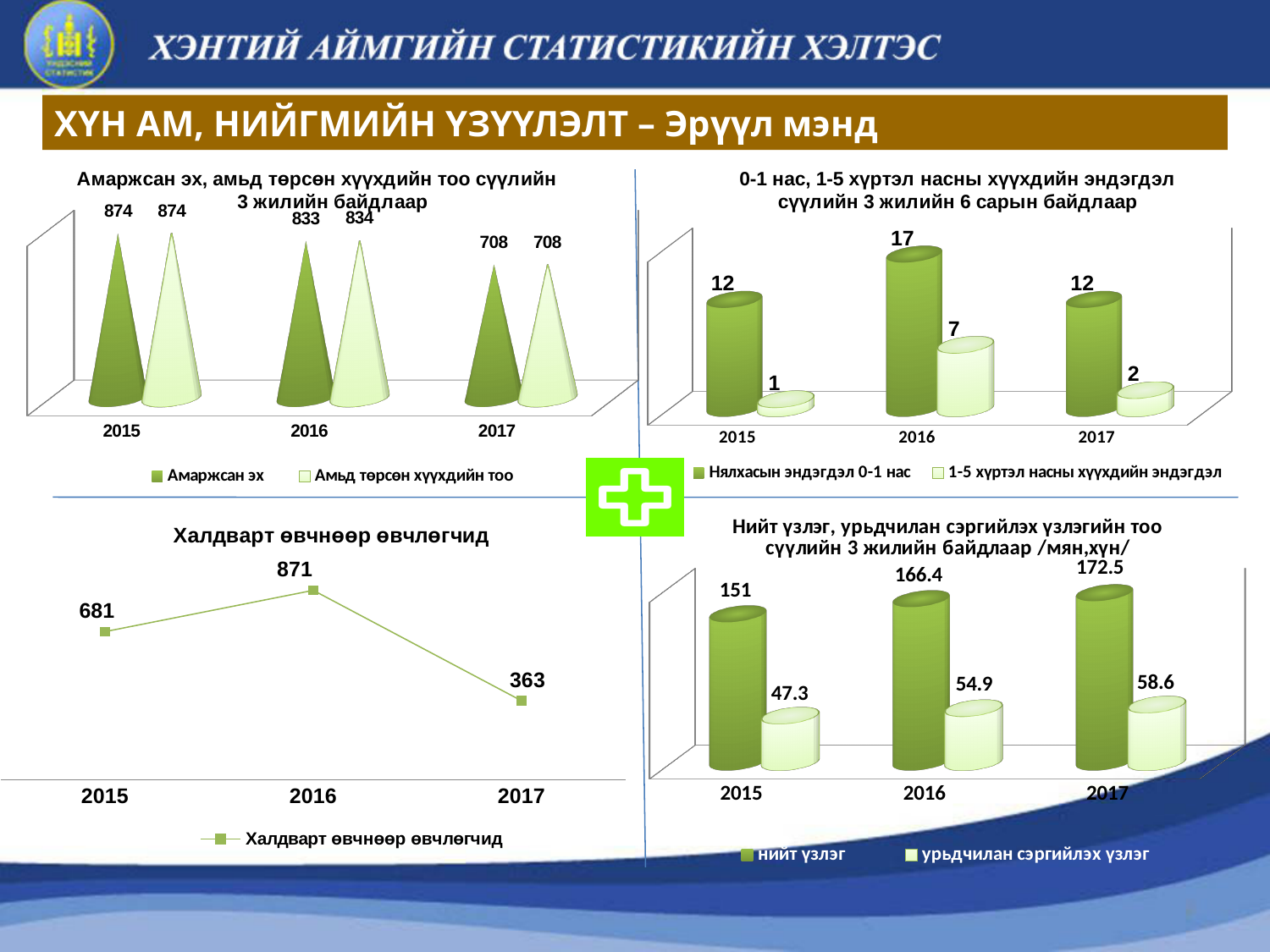
In the top-right chart (0-1 нас, 1-5 хүртэл насны хүүхдийн эндэгдэл), what is the difference between Нялхасын эндэгдэл 0-1 нас and 1-5 хүртэл насны хүүхдийн эндэгдэл in 2015? 11 In the bottom-right chart (Нийт үзлэг, урьдчилан сэргийлэх үзлэгийн тоо), how many series does the legend list? 2 In the top-left chart (Амаржсан эх, амьд төрсөн хүүхдийн тоо), does the Амаржсан эх series rise or fall from 2015 to 2017? fall In the bottom-left chart (Халдварт өвчнөөр өвчлөгчид), what is the value for 2016? 871 In the bottom-left chart (Халдварт өвчнөөр өвчлөгчид), which year has the lowest value? 2017 In the top-left chart (Амаржсан эх, амьд төрсөн хүүхдийн тоо), what is the value for Амьд төрсөн хүүхдийн тоо in 2017? 708 In the top-right chart (0-1 нас, 1-5 хүртэл насны хүүхдийн эндэгдэл), what is the value for 1-5 хүртэл насны хүүхдийн эндэгдэл in 2016? 7 In the bottom-left chart (Халдварт өвчнөөр өвчлөгчид), what type of chart is shown? line chart In the top-right chart (0-1 нас, 1-5 хүртэл насны хүүхдийн эндэгдэл), which year has the highest value for Нялхасын эндэгдэл 0-1 нас? 2016 In the top-left chart (Амаржсан эх, амьд төрсөн хүүхдийн тоо), what is the value for Амаржсан эх in 2016? 833 In the bottom-right chart (Нийт үзлэг, урьдчилан сэргийлэх үзлэгийн тоо), which is larger: нийт үзлэг in 2016 or нийт үзлэг in 2017? нийт үзлэг in 2017 In the bottom-right chart (Нийт үзлэг, урьдчилан сэргийлэх үзлэгийн тоо), what is the value for урьдчилан сэргийлэх үзлэг in 2015? 47.3